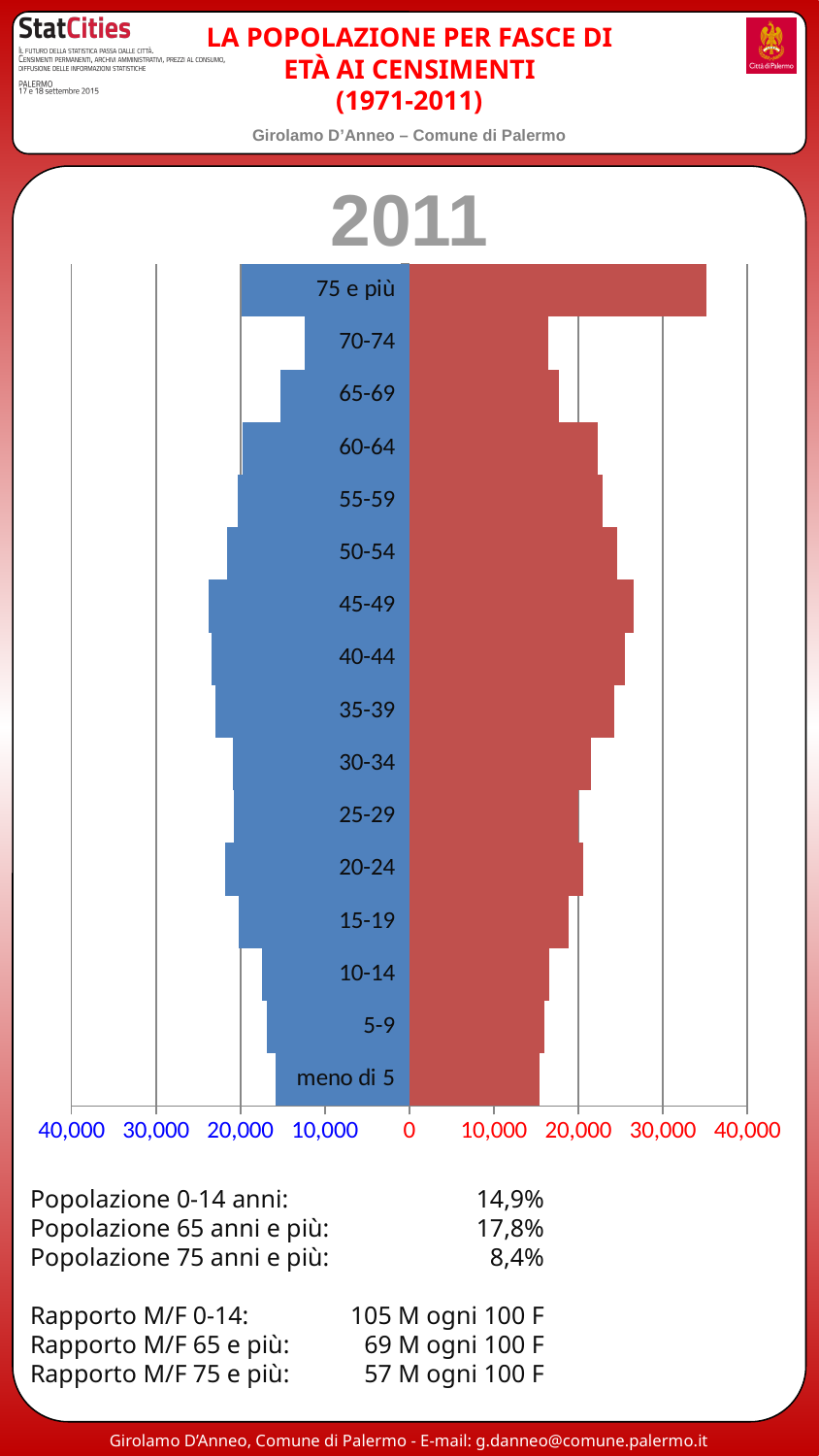
How many age groups are shown on the chart? 16 For the 70-74 age group, which bar is longer, the blue one or the red one? red Which age group has the longest red bar? 75 e più Is the red bar for 75 e più greater or less than 30,000? greater What is the highest value shown on the horizontal axis? 40,000 Is the blue bar for 70-74 greater or less than 20,000? less What kind of chart is shown on the slide? bar chart What year is shown as the title of the chart? 2011 Is the red bar for meno di 5 greater or less than 20,000? less Which age group has the shortest blue bar? 70-74 For the 75 e più age group, which bar is longer, the blue one or the red one? red